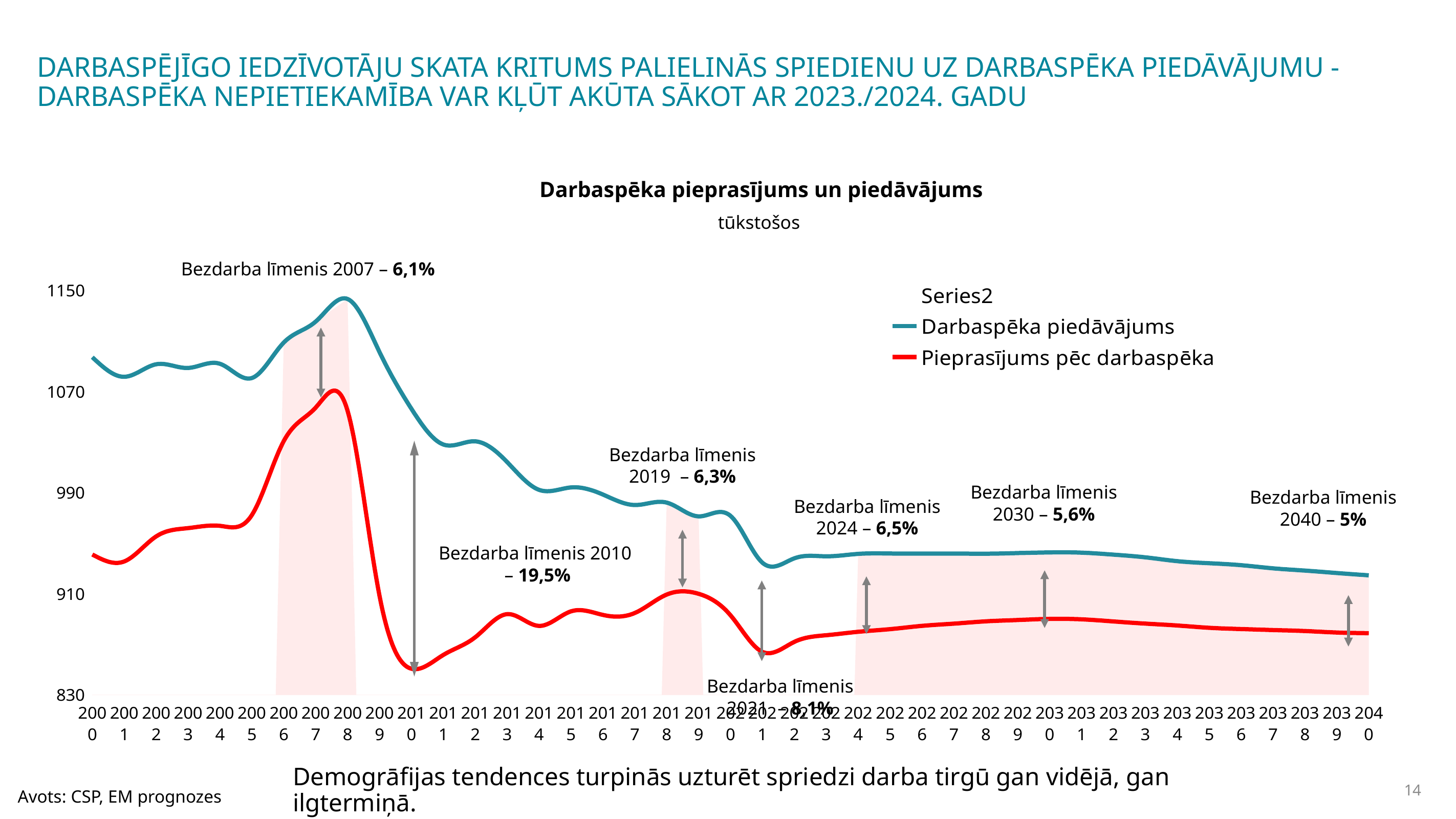
Does the Darbaspēka piedāvājums line rise or fall between 2030 and 2040? fall What is the title of the chart? Darbaspēka pieprasījums un piedāvājums Does the Pieprasījums pēc darbaspēka line rise or fall between 2010 and 2019? rise Which series is drawn in red? Pieprasījums pēc darbaspēka What kind of chart is shown on the slide? line chart How many entries does the chart legend list? 3 Is the value of Pieprasījums pēc darbaspēka in 2010 greater or less than 910? less Is the value of Pieprasījums pēc darbaspēka in 2040 greater or less than 910? less Is the value of Darbaspēka piedāvājums in 2008 greater or less than 1070? greater How many years are shown on the x axis? 41 In 2010, which series has the larger value, Darbaspēka piedāvājums or Pieprasījums pēc darbaspēka? Darbaspēka piedāvājums